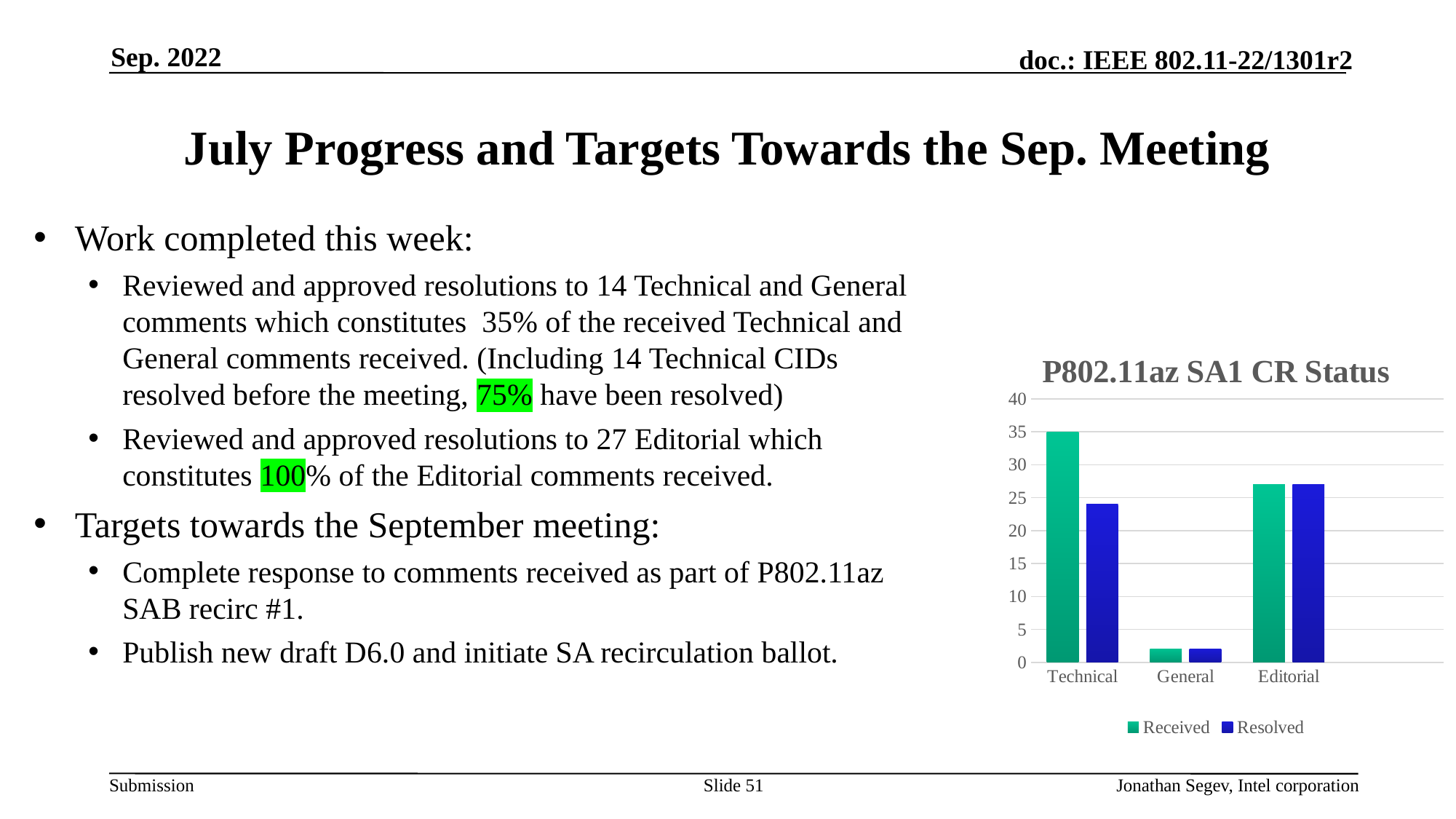
Which category has the highest Resolved value? Editorial Which category has the lowest Received value? General Is the Received value for Technical greater or less than 30? greater How many categories are shown on the x axis of the chart? 3 Which series is shown in blue in the chart legend? Resolved How many series does the chart legend list? 2 What is the title of the chart? P802.11az SA1 CR Status Is the Received value for General greater or less than 5? less Which category has the highest Received value? Technical What kind of chart is shown on the slide? bar chart For Technical, which is larger: Received or Resolved? Received